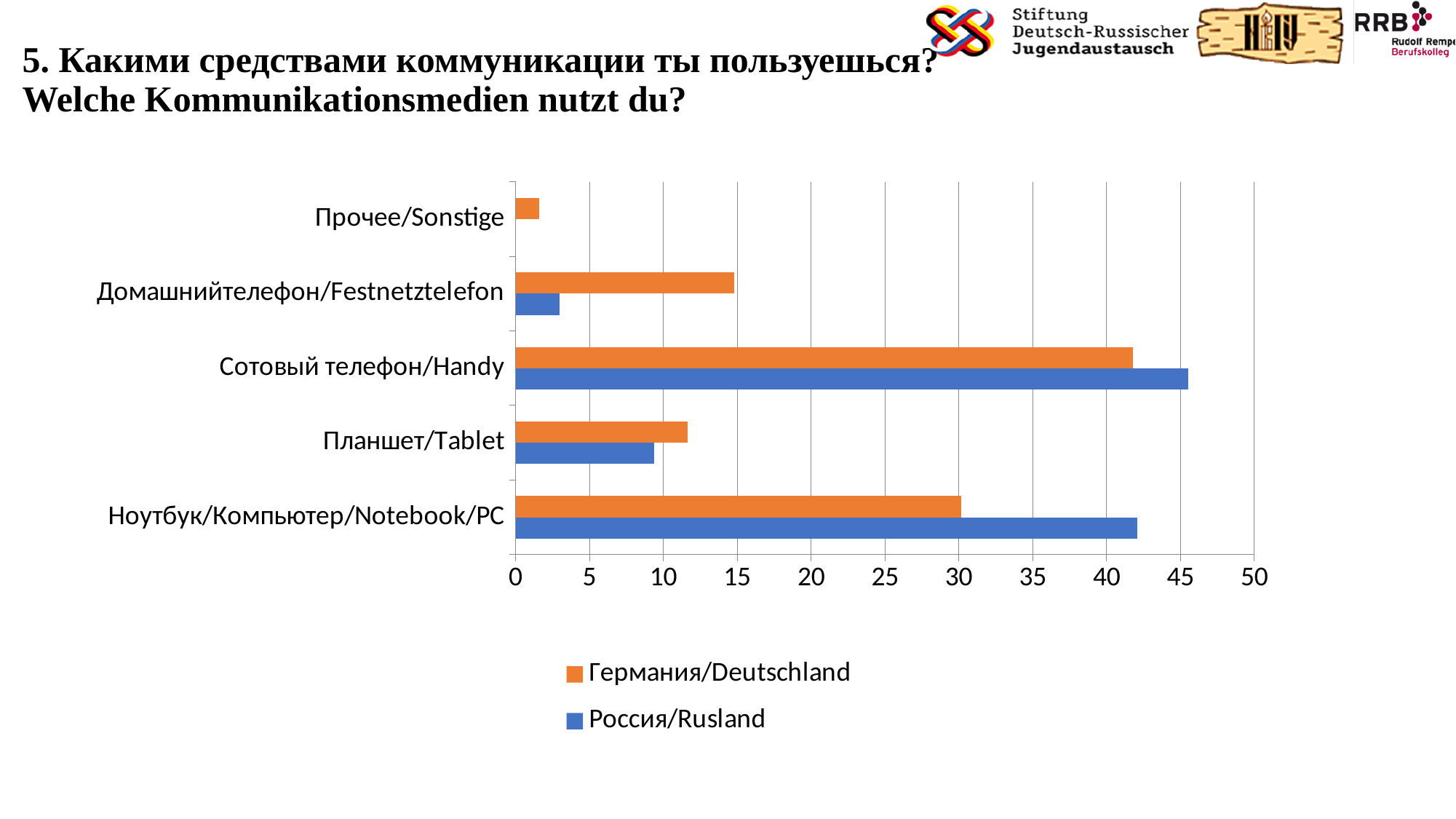
How many categories are shown on the chart? 5 Is the value for Домашнийтелефон/Festnetztelefon for Россия/Rusland greater or less than 5? less What kind of chart is shown on the slide? bar chart Which category has the highest value for Германия/Deutschland? Сотовый телефон/Handy How many series does the legend list? 2 Which category has the highest value for Россия/Rusland? Сотовый телефон/Handy For Ноутбук/Компьютер/Notebook/PC, which series has the larger value, Германия/Deutschland or Россия/Rusland? Россия/Rusland Which colour represents Россия/Rusland in the chart? blue Which category has the lowest value for Германия/Deutschland? Прочее/Sonstige Is the value for Сотовый телефон/Handy for Россия/Rusland greater or less than 40? greater For Домашнийтелефон/Festnetztelefon, which series has the larger value, Германия/Deutschland or Россия/Rusland? Германия/Deutschland Is the value for Ноутбук/Компьютер/Notebook/PC for Германия/Deutschland greater or less than 25? greater